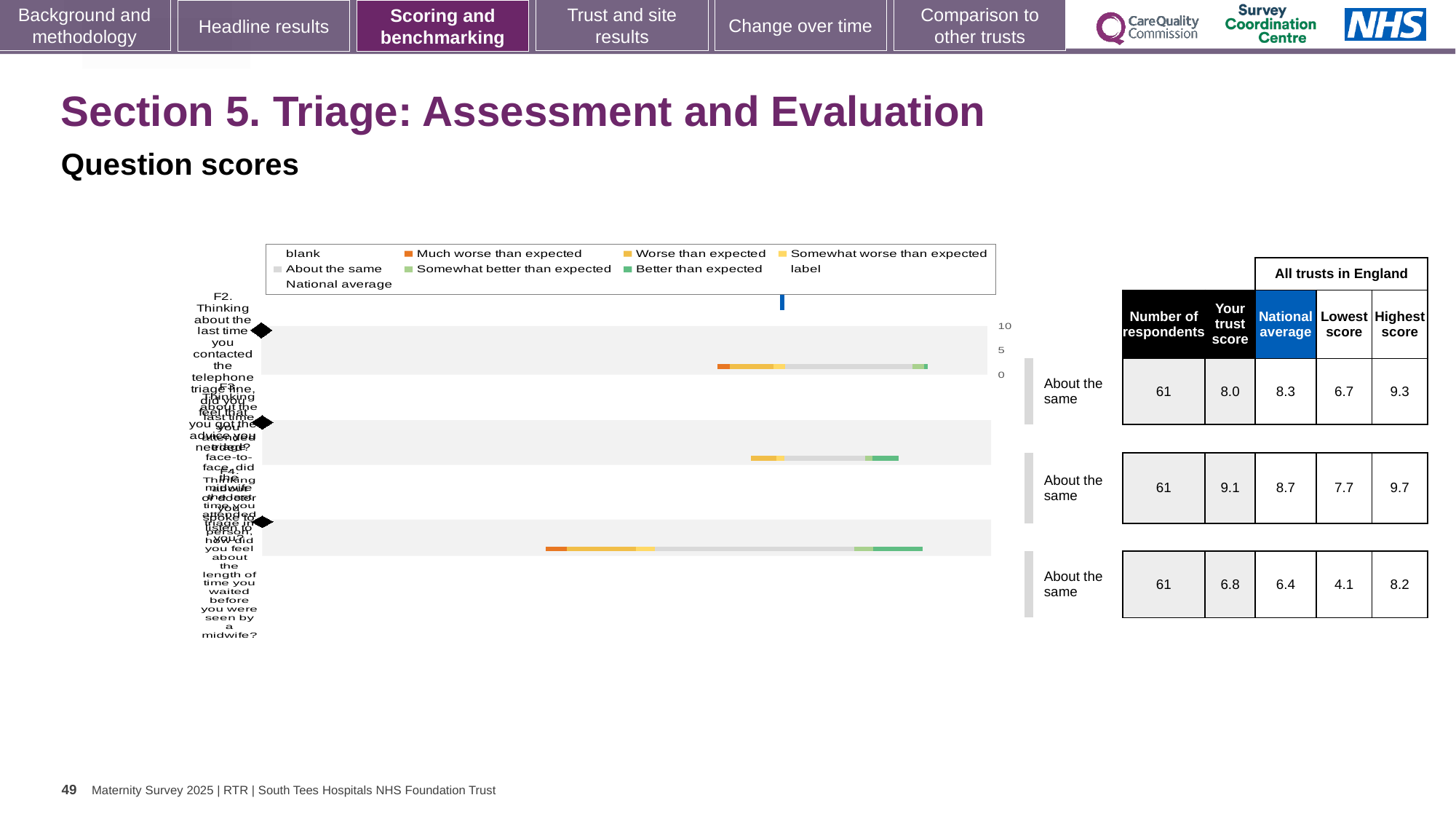
What kind of chart is shown on the slide? bar chart In the table next to the chart, what is 'Your trust score' for the first question (F2)? 8.0 How many questions (F2, F3, F4) are plotted as rows in the chart? 3 Which question has the highest 'Your trust score' in the table next to the chart? F3 In the table next to the chart, how many respondents are listed for the third question (F4)? 61 Which question has the lowest 'Your trust score' in the table next to the chart? F4 In the table next to the chart, what is the national average for the second question (F3)? 8.7 In the chart legend, what colour represents 'Much worse than expected'? orange For the first question (F2), which is larger: 'Your trust score' or the national average? national average In the chart legend, what colour represents 'Better than expected'? green What benchmark category is shown beside the chart for the third question (F4)? About the same For the second question (F3), what is the difference between 'Your trust score' and the national average? 0.4